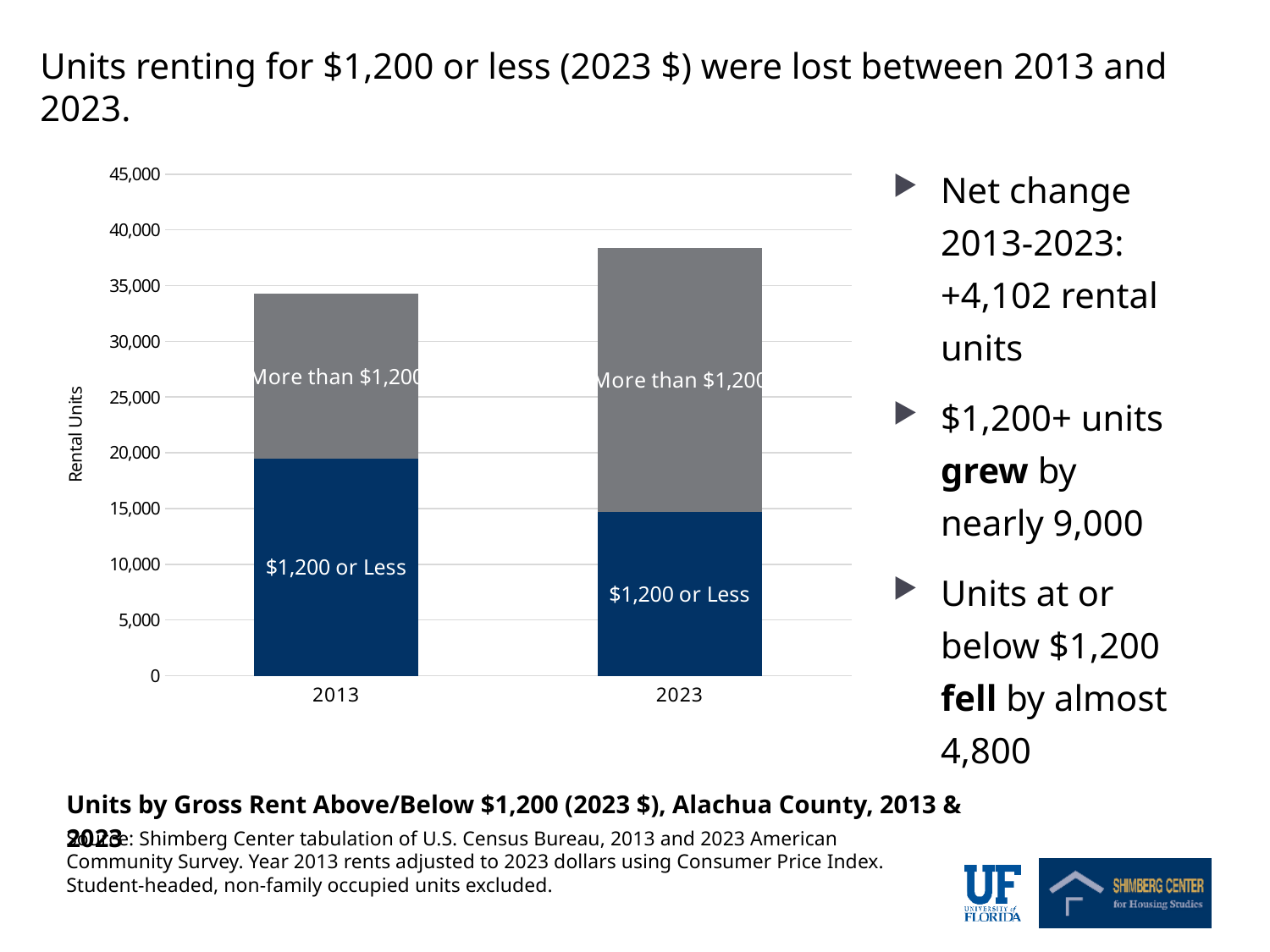
Is the value for $1,200 or Less units in 2023 greater or less than 10,000? greater Is the total height of the 2013 bar greater or less than 30,000? greater What is the label on the vertical axis of the chart? Rental Units Which year has the taller total bar, 2013 or 2023? 2023 Is the total height of the 2023 bar greater or less than 40,000? less Does the total number of rental units rise or fall from 2013 to 2023? rise How many years (categories) are shown on the x axis of the chart? 2 Which year has the larger number of units renting for $1,200 or less, 2013 or 2023? 2013 How many rent series are stacked in each bar of the chart? 2 Which series is shown in dark blue at the bottom of each bar? $1,200 or Less What kind of chart is shown on the slide? Stacked bar chart